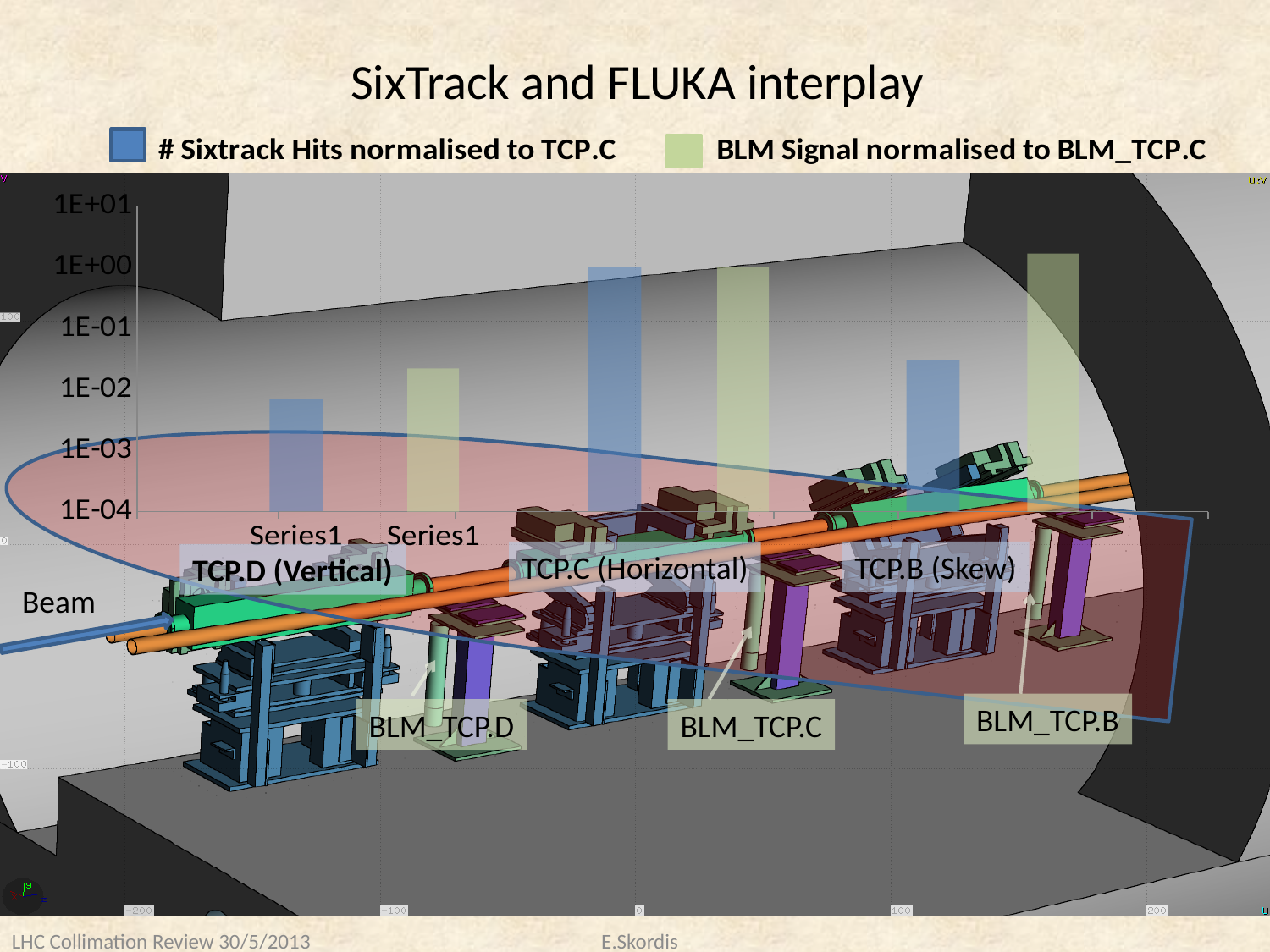
Is the BLM Signal value for TCP.B (Skew) greater or less than 1E-01? greater What colour represents the BLM Signal normalised to BLM_TCP.C series? green Which collimator has the lowest BLM Signal normalised to BLM_TCP.C? TCP.D (Vertical) Which collimator has the lowest # Sixtrack Hits normalised to TCP.C? TCP.D (Vertical) How many collimator categories (TCP.D, TCP.C, TCP.B) are plotted? 3 Is the # Sixtrack Hits value for TCP.D (Vertical) greater or less than 1E-02? less How many series does the legend list? 2 Is the # Sixtrack Hits value for TCP.B (Skew) greater or less than 1E-01? less What kind of chart is overlaid on the slide? bar chart Which collimator has the highest # Sixtrack Hits normalised to TCP.C? TCP.C (Horizontal) For TCP.D (Vertical), which is larger: the # Sixtrack Hits bar or the BLM Signal bar? BLM Signal